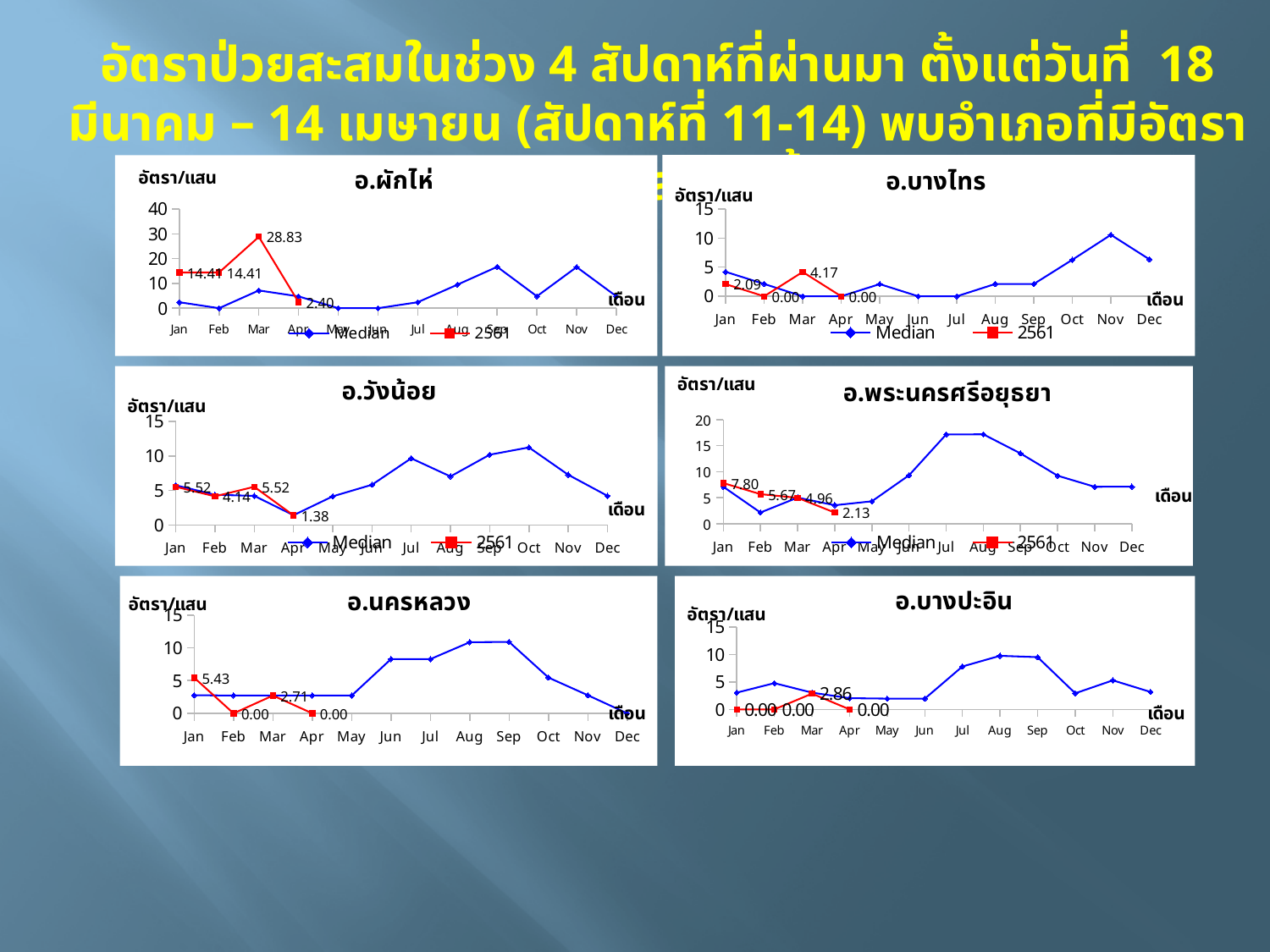
In the อ.พระนครศรีอยุธยา chart, is the Median value for Jul greater or less than 15? greater In the อ.ผักไห่ chart, which is larger, the 2561 value for Jan or for Mar? Mar In the อ.พระนครศรีอยุธยา chart, what is the difference between the 2561 values for Jan and Apr? 5.67 In the อ.วังน้อย chart, which month has the lowest 2561 value? Apr In the อ.นครหลวง chart, what is the 2561 value for Jan? 5.43 What kind of chart is the อ.บางไทร chart? line chart In the อ.บางไทร chart, what is the 2561 value for Mar? 4.17 In the อ.ผักไห่ chart, what is the 2561 value for Mar? 28.83 In the อ.พระนครศรีอยุธยา chart, does the 2561 series rise or fall from Jan to Apr? fall How many series does the legend of the อ.วังน้อย chart list? 2 In the อ.ผักไห่ chart, what is the 2561 value for Apr? 2.40 In the อ.บางปะอิน chart, which month has the highest 2561 value? Mar